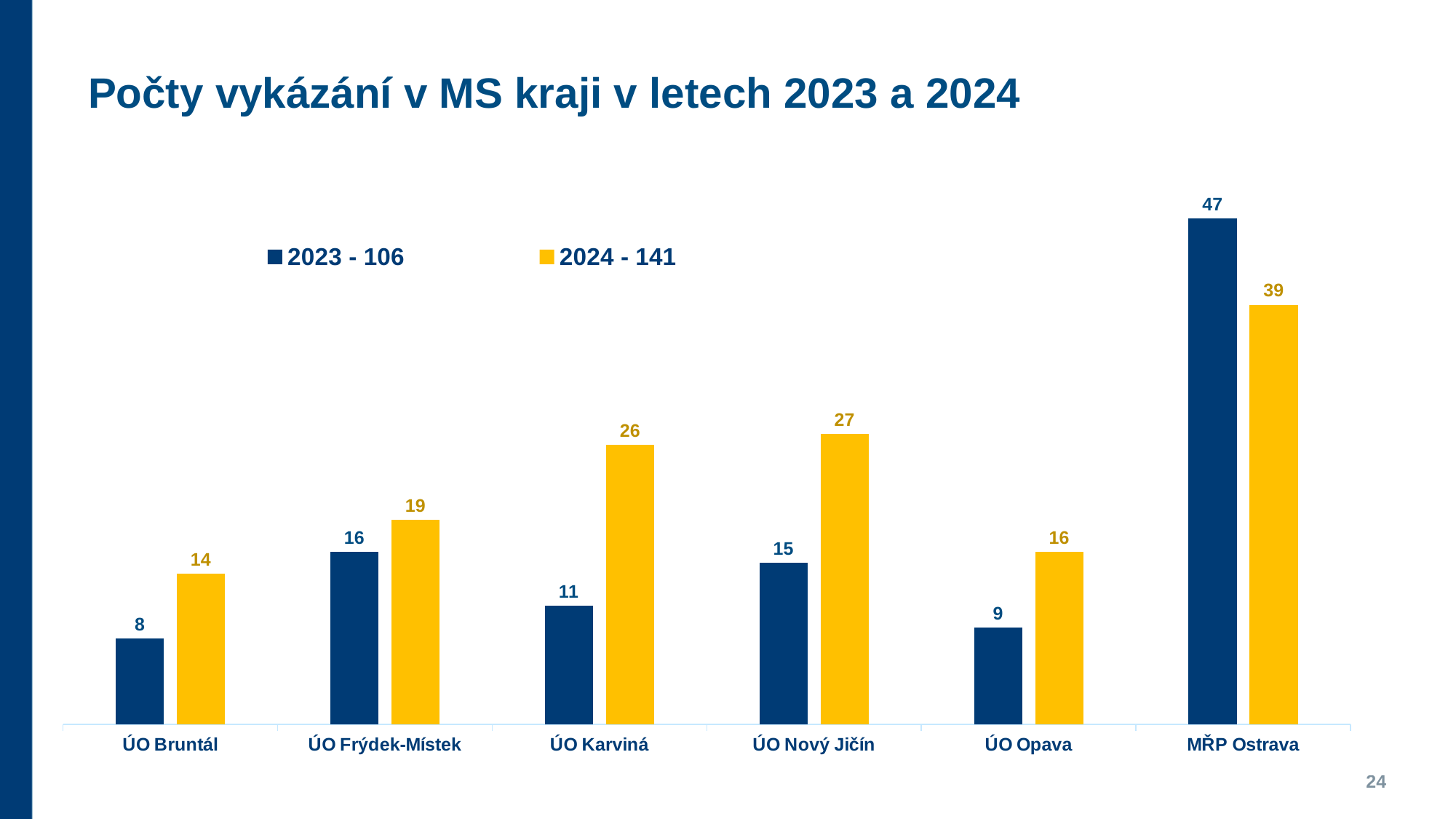
What is the difference between the 2024 - 141 and 2023 - 106 values for ÚO Nový Jičín? 12 What is the value for MŘP Ostrava in the 2023 - 106 series? 47 What is the title of the slide? Počty vykázání v MS kraji v letech 2023 a 2024 What kind of chart is shown on the slide? bar chart Which is larger for MŘP Ostrava: the 2023 - 106 value or the 2024 - 141 value? 2023 - 106 How many categories are shown on the x axis? 6 What is the value for ÚO Karviná in the 2024 - 141 series? 26 Which category has the highest value in the 2024 - 141 series? MŘP Ostrava What is the value for ÚO Opava in the 2023 - 106 series? 9 Which category has the lowest value in the 2023 - 106 series? ÚO Bruntál Which is larger for ÚO Frýdek-Místek: the 2023 - 106 value or the 2024 - 141 value? 2024 - 141 How many series does the legend list? 2